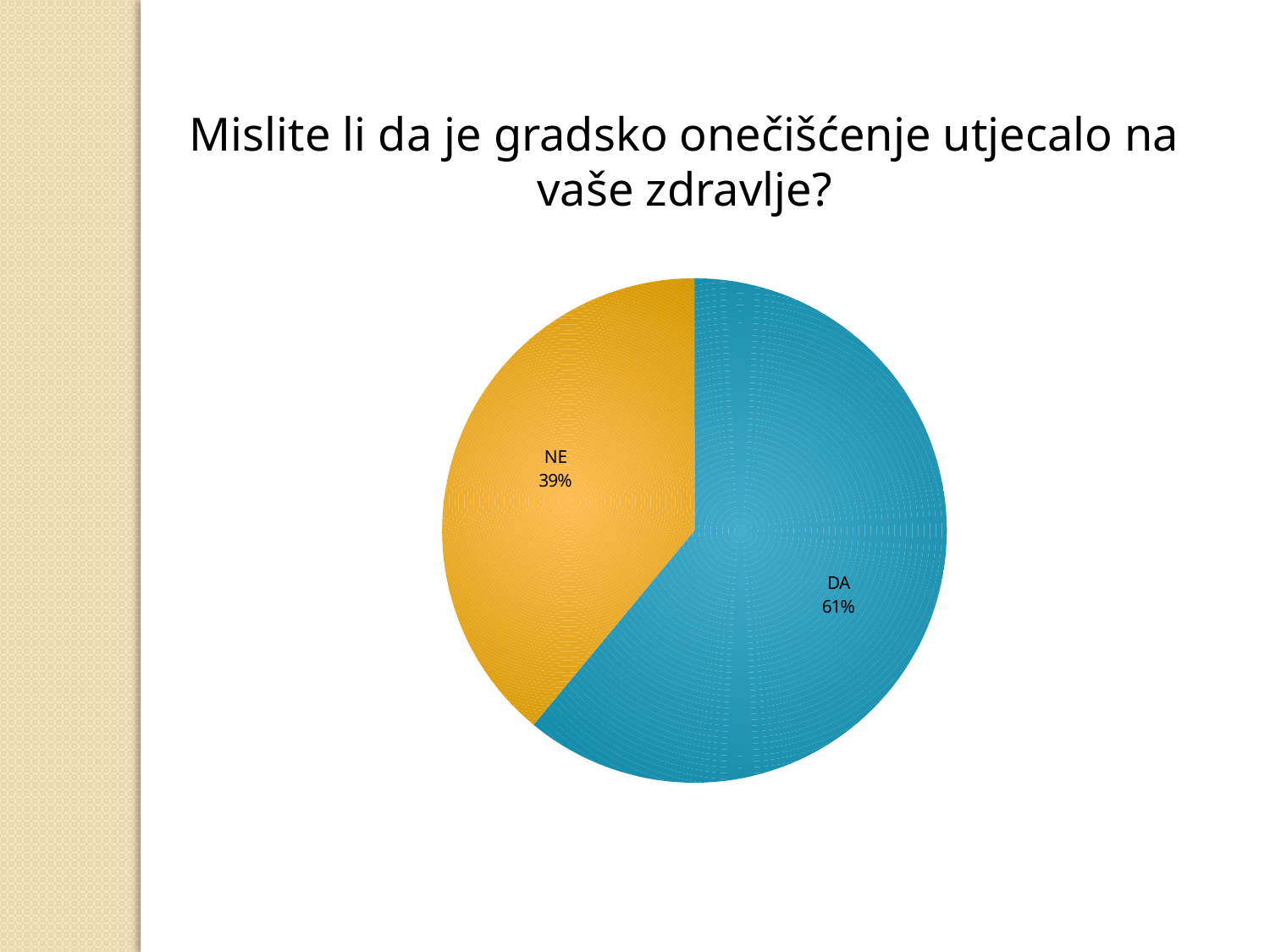
Which slice is the smallest in the pie chart? NE What share of the pie does the NE slice represent? 39% What colour is the DA slice? blue How many slices does the pie chart have? 2 What is the title of the chart? Mislite li da je gradsko onečišćenje utjecalo na vaše zdravlje? What share of the pie does the DA slice represent? 61% What kind of chart is shown on the slide? pie chart What is the difference in percentage points between the DA and NE slices? 22% Which is larger, the DA slice or the NE slice? DA Which slice is the largest in the pie chart? DA